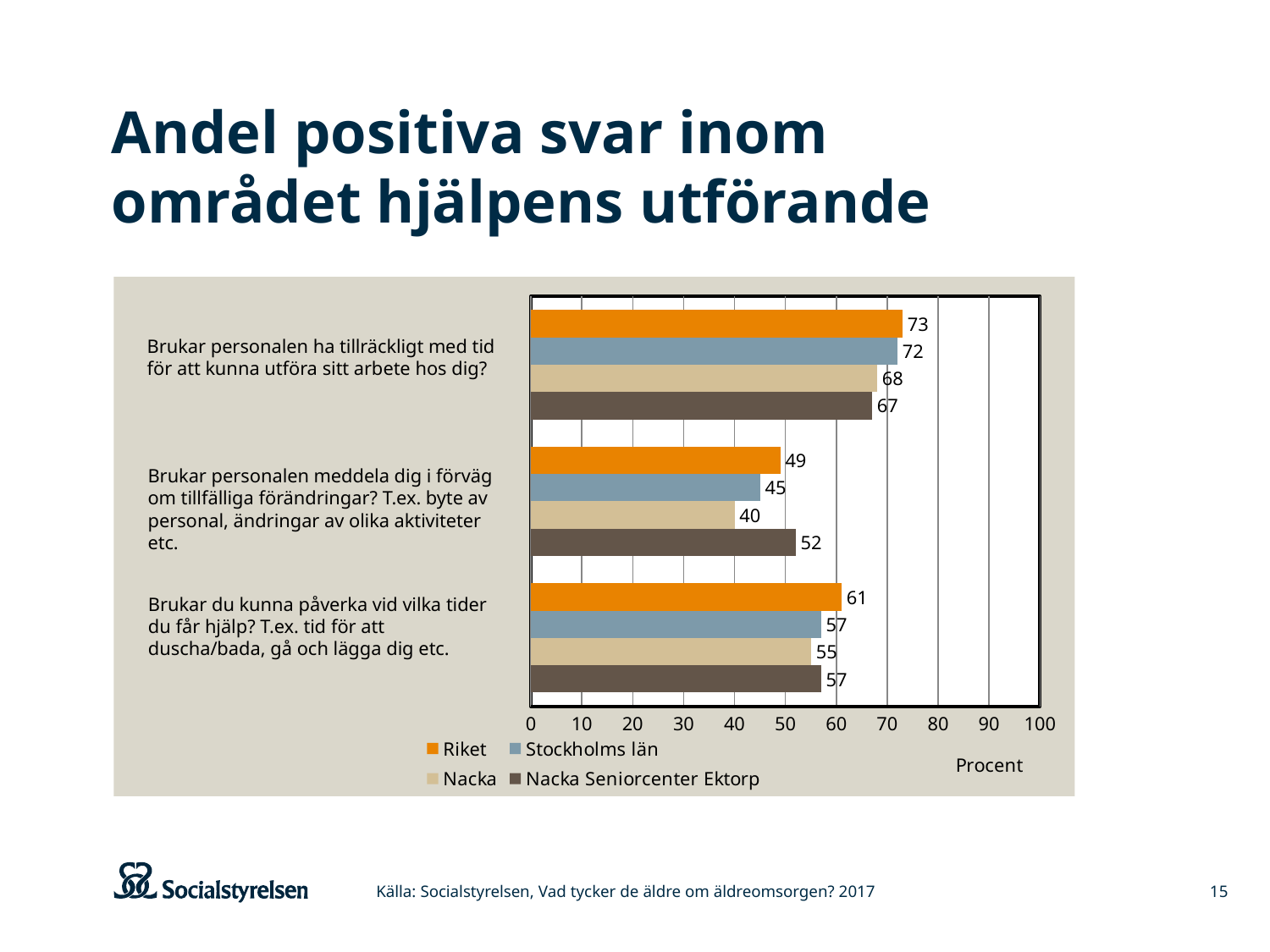
Which series has the lowest value on the question "Brukar personalen meddela dig i förväg om tillfälliga förändringar?"? Nacka What is the difference between Riket and Nacka on the question "Brukar personalen meddela dig i förväg om tillfälliga förändringar?"? 9 What is the difference between Riket and Nacka Seniorcenter Ektorp on the question "Brukar personalen ha tillräckligt med tid för att kunna utföra sitt arbete hos dig?"? 6 What is the label of the x axis? Procent How many series does the legend list? 4 Which is larger on the question "Brukar personalen meddela dig i förväg om tillfälliga förändringar?": Riket or Nacka Seniorcenter Ektorp? Nacka Seniorcenter Ektorp What is the value for Riket on the question "Brukar personalen ha tillräckligt med tid för att kunna utföra sitt arbete hos dig?"? 73 Which series has the highest value on the question "Brukar personalen ha tillräckligt med tid för att kunna utföra sitt arbete hos dig?"? Riket What is the value for Nacka on the question "Brukar du kunna påverka vid vilka tider du får hjälp?"? 55 How many question categories are shown on the chart? 3 What kind of chart is shown on the slide? Bar chart What is the value for Nacka Seniorcenter Ektorp on the question "Brukar personalen meddela dig i förväg om tillfälliga förändringar?"? 52